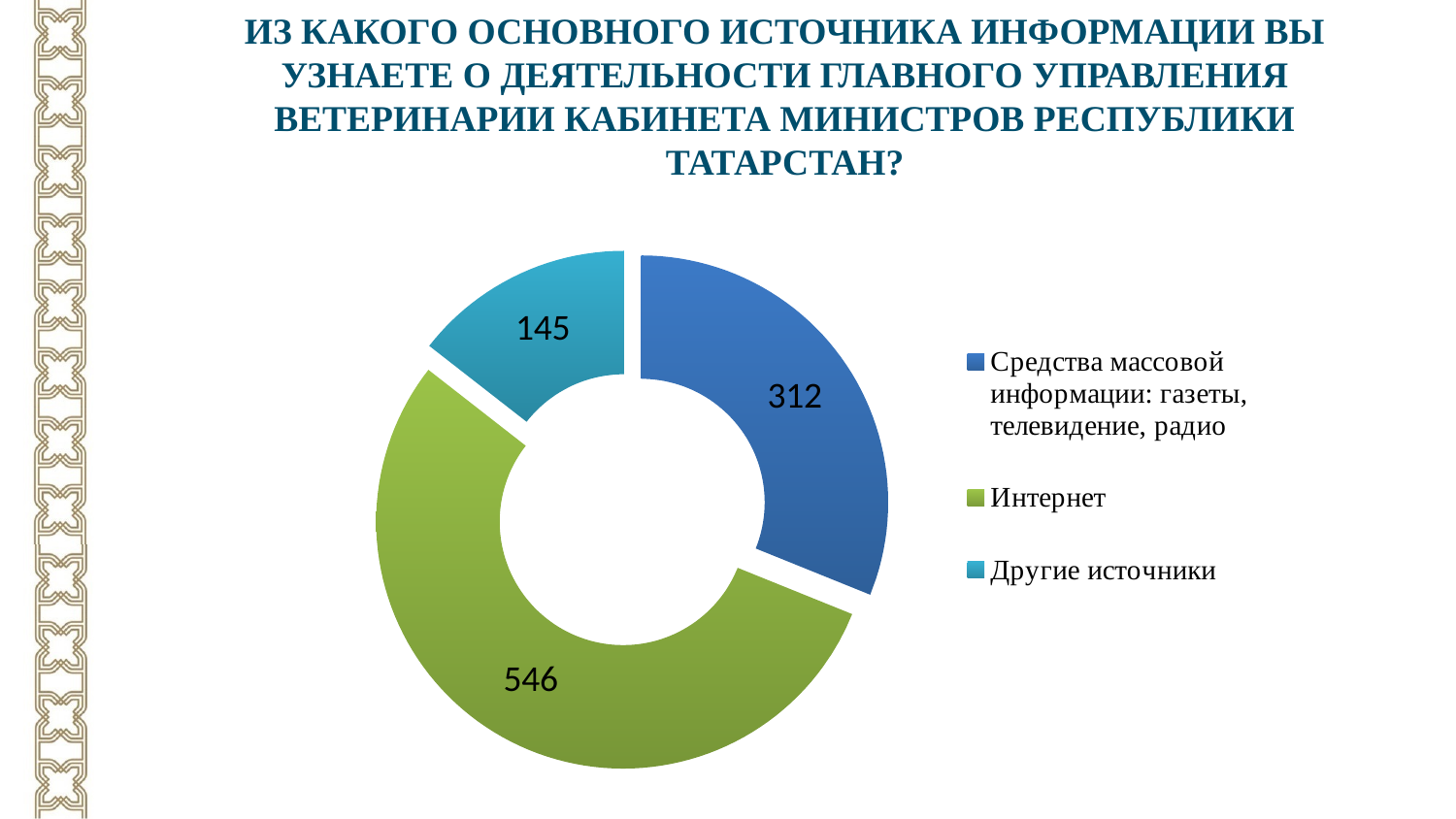
How many categories does the chart show? 3 Which is larger: the value for Интернет or the value for Другие источники? Интернет Which category has the lowest value? Другие источники What is the difference between the values for Интернет and Средства массовой информации: газеты, телевидение, радио? 234 What is the difference between the values for Средства массовой информации: газеты, телевидение, радио and Другие источники? 167 What kind of chart is shown on the slide? Doughnut chart Which colour represents Другие источники in the chart? Teal (light blue) What is the total of all values shown in the chart? 1003 Which category has the highest value? Интернет What value is shown for Другие источники? 145 What value is shown for Интернет? 546 What value is shown for Средства массовой информации: газеты, телевидение, радио? 312